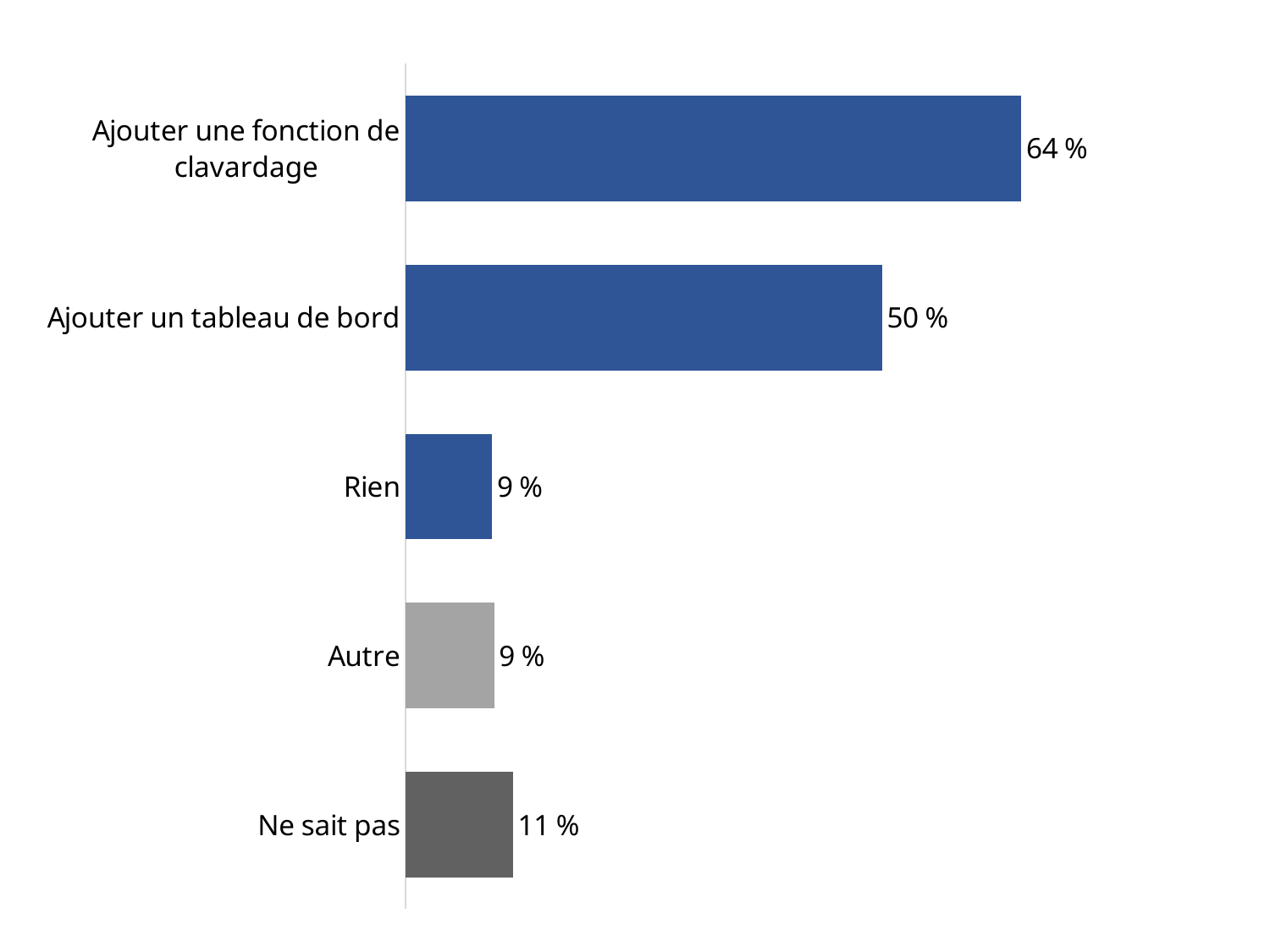
Which is larger, the value for "Ajouter un tableau de bord" or the value for "Ne sait pas"? Ajouter un tableau de bord Which is larger, the value for "Ne sait pas" or the value for "Rien"? Ne sait pas How many categories are shown in the chart? 5 What is the value for "Rien"? 9 % What is the value for "Ajouter un tableau de bord"? 50 % Which category has the highest value? Ajouter une fonction de clavardage What kind of chart is shown on the slide? Bar chart What is the difference between the values for "Ne sait pas" and "Autre"? 2 % What is the value for "Ne sait pas"? 11 % What colour is the bar for "Ne sait pas"? Dark grey What is the value for "Ajouter une fonction de clavardage"? 64 % What is the difference between the values for "Ajouter une fonction de clavardage" and "Ajouter un tableau de bord"? 14 %